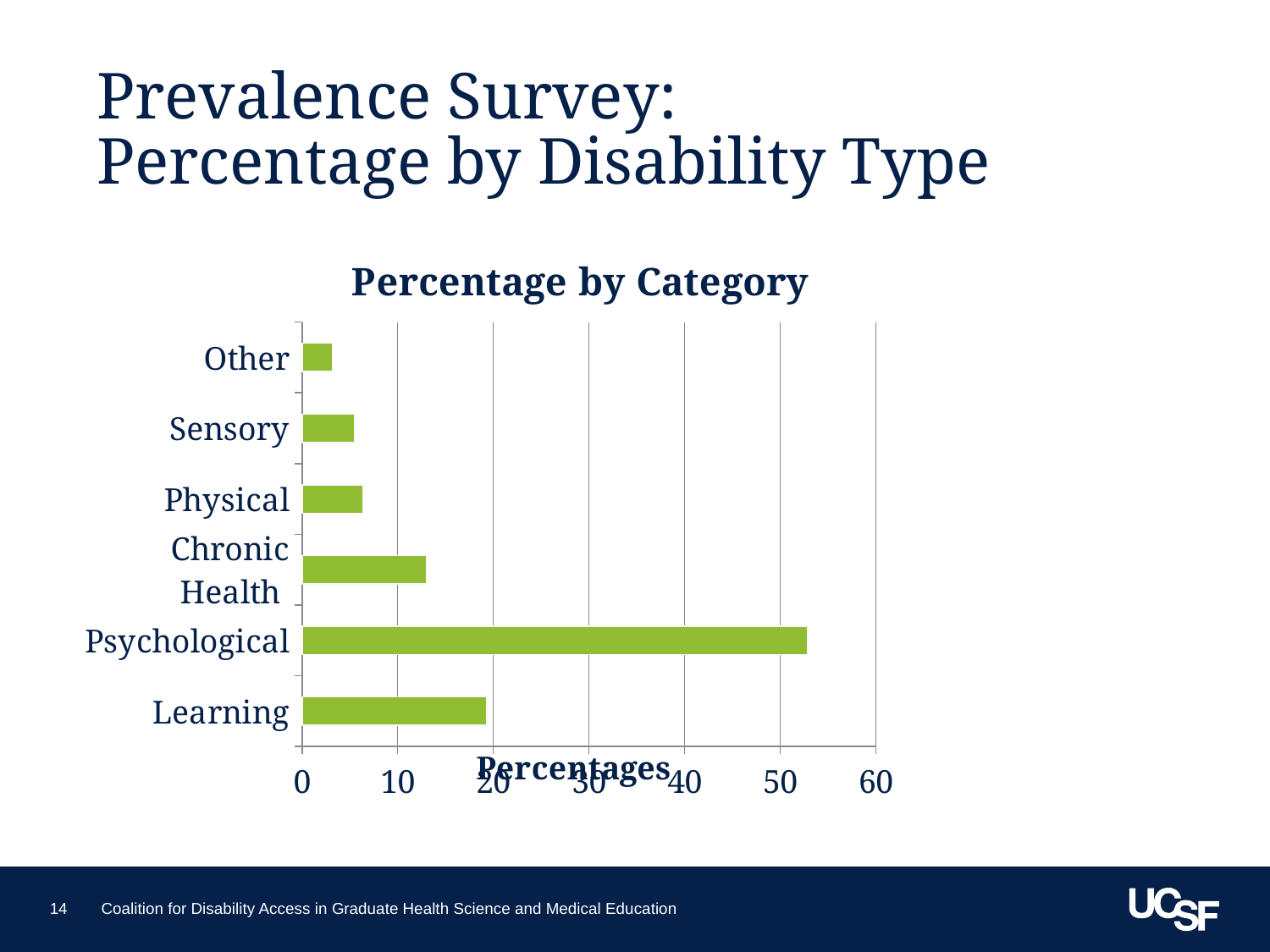
Is the value for Other greater or less than 10? less Which is larger, the value for Chronic Health or the value for Physical? Chronic Health What kind of chart is shown on the slide? Bar chart What is the label on the horizontal axis of the chart? Percentages Is the value for Chronic Health greater or less than 10? greater Which category has the highest percentage? Psychological Is the value for Psychological greater or less than 50? greater What is the title of the chart? Percentage by Category How many disability categories are plotted in the chart? 6 Which is larger, the value for Psychological or the value for Learning? Psychological Which category has the lowest percentage? Other